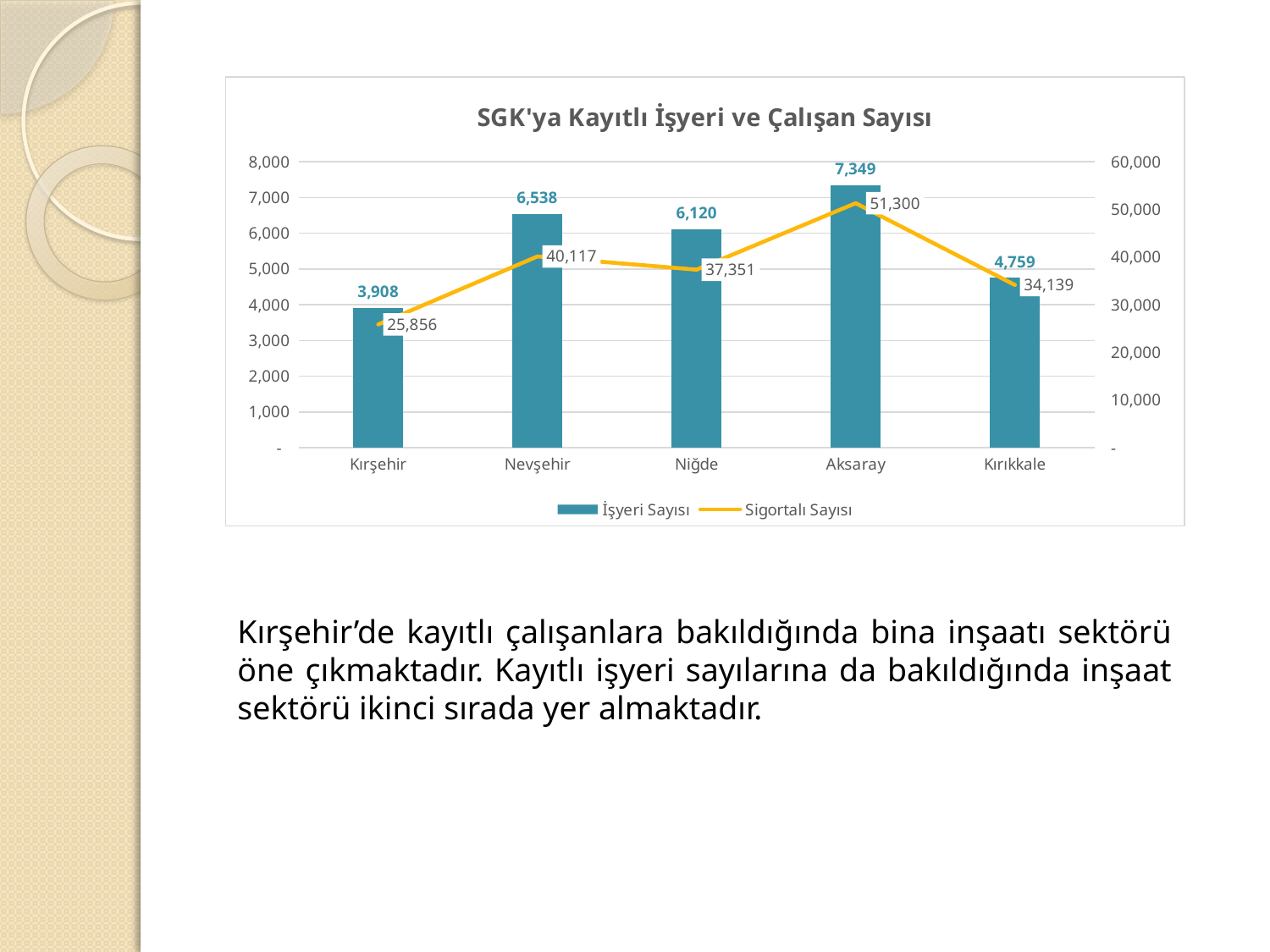
What is the İşyeri Sayısı value for Niğde? 6,120 What is the difference in İşyeri Sayısı between Nevşehir and Kırıkkale? 1,779 What is the title of the chart? SGK'ya Kayıtlı İşyeri ve Çalışan Sayısı Which has a larger Sigortalı Sayısı, Nevşehir or Niğde? Nevşehir How many provinces are shown on the x axis? 5 What is the İşyeri Sayısı value for Aksaray? 7,349 What is the Sigortalı Sayısı value for Kırıkkale? 34,139 Which province has the lowest Sigortalı Sayısı? Kırşehir What kind of chart is used for the İşyeri Sayısı series? Bar chart Which province has the highest İşyeri Sayısı? Aksaray What is the Sigortalı Sayısı value for Kırşehir? 25,856 How many series does the legend list? 2